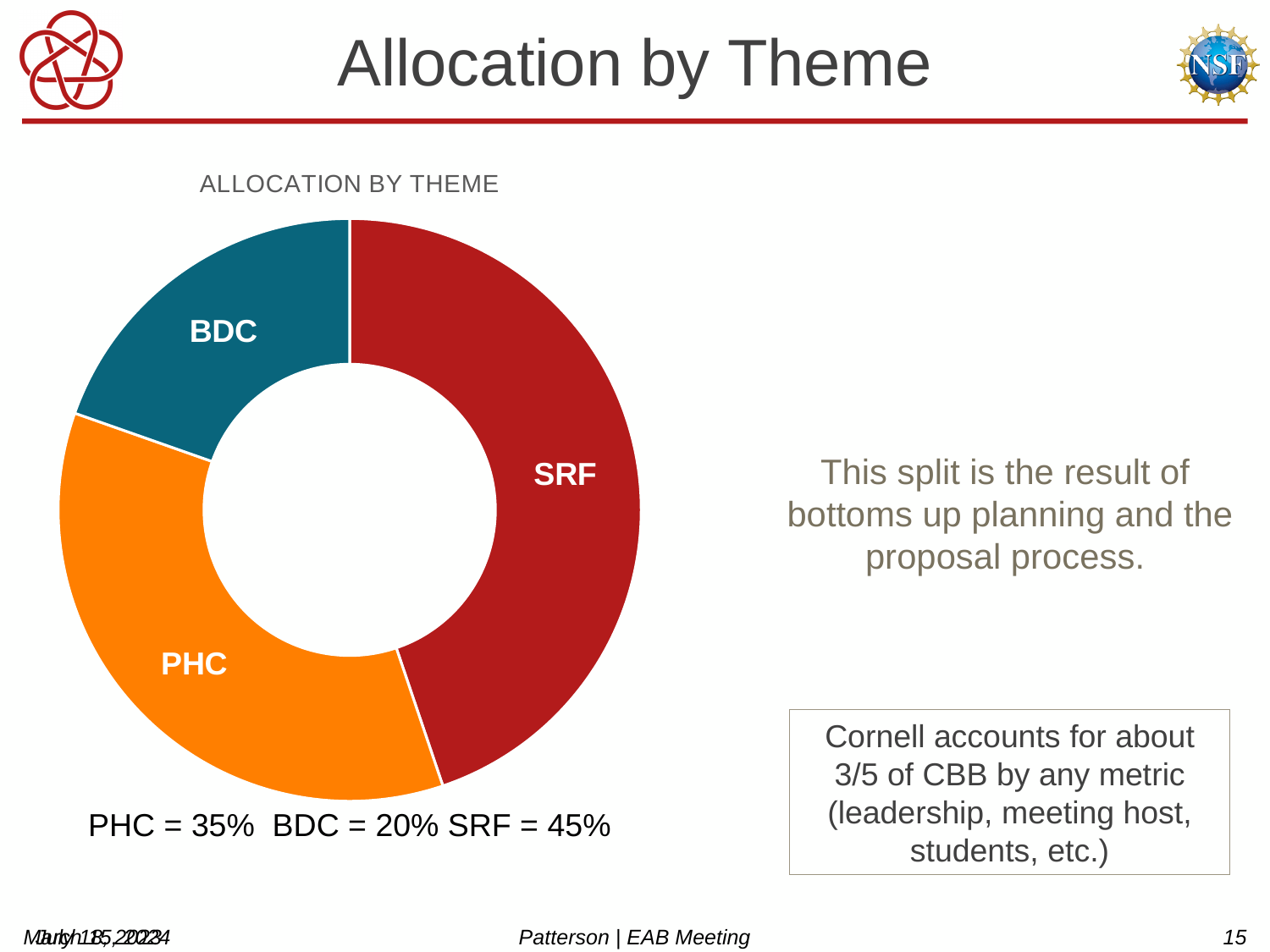
What is the difference in percentage points between the SRF and PHC shares? 10% What is the title of the chart? ALLOCATION BY THEME What share of the allocation goes to BDC? 20% What share of the allocation goes to PHC? 35% What is the difference in percentage points between the PHC and BDC shares? 15% Which theme has the largest share of the allocation? SRF What share of the allocation goes to SRF? 45% Which theme has the smallest share of the allocation? BDC What colour is the SRF slice of the chart? red What kind of chart is shown on the slide? doughnut chart How many themes (slices) does the chart show? 3 Which has a larger share, PHC or BDC? PHC